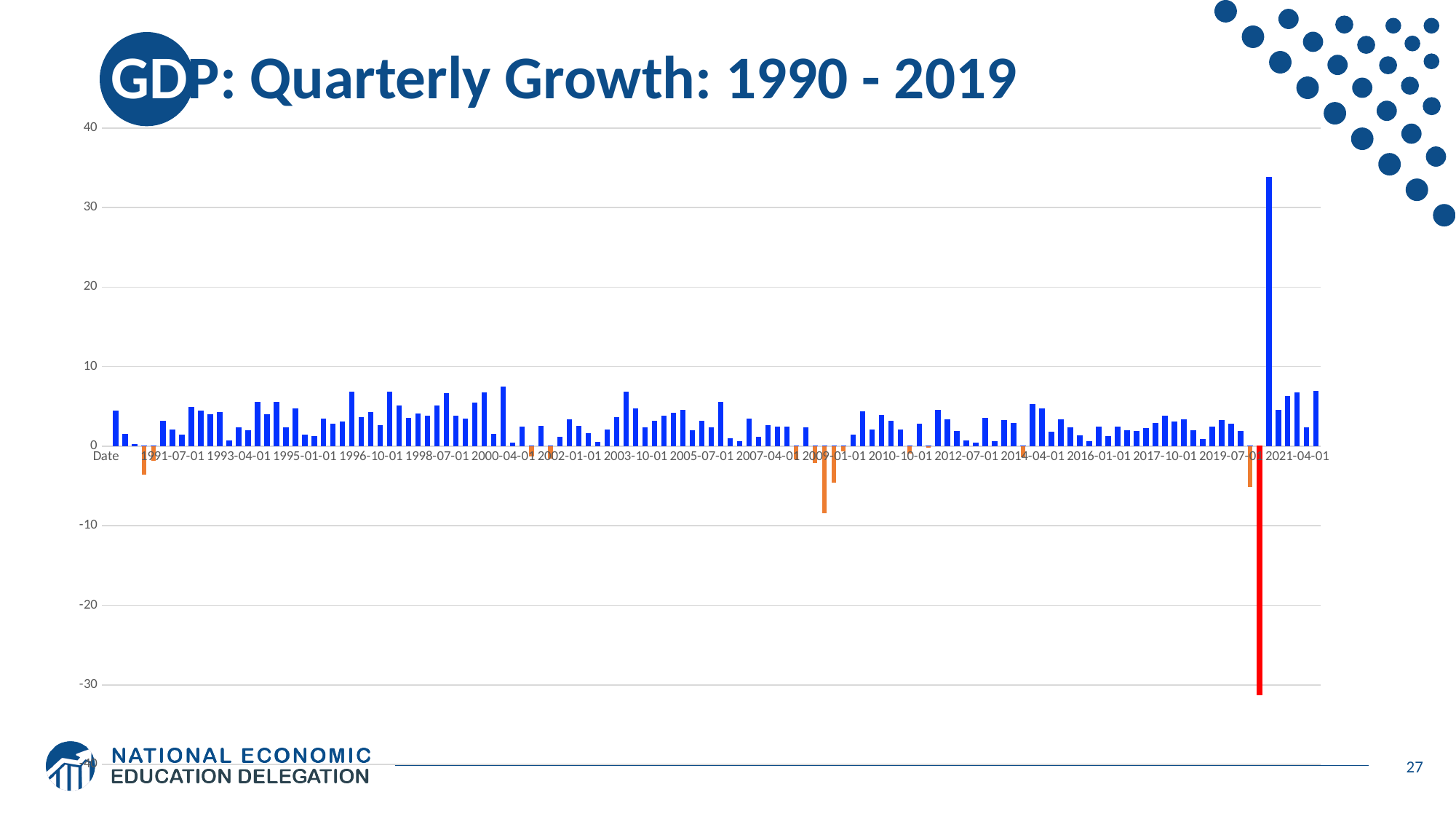
Is the value of the red bar on the chart greater or less than -30? less Is the highest bar on the chart located before or after the 2019-07-01 axis label? after Which colour is used for the bar with the lowest value on the chart? red Is the value of the bar at 1991-07-01 greater or less than 0? greater What is the highest value shown on the vertical axis of the chart? 40 Which is larger in magnitude: the tallest blue bar or the red bar? the tallest blue bar What kind of chart is shown on the slide? bar chart What is the title of the chart on the slide? GDP: Quarterly Growth: 1990 - 2019 Is the value of the lowest orange bar, near 2009-01-01, greater or less than -10? greater Is the lowest bar on the chart located before or after the 2019-07-01 axis label? after